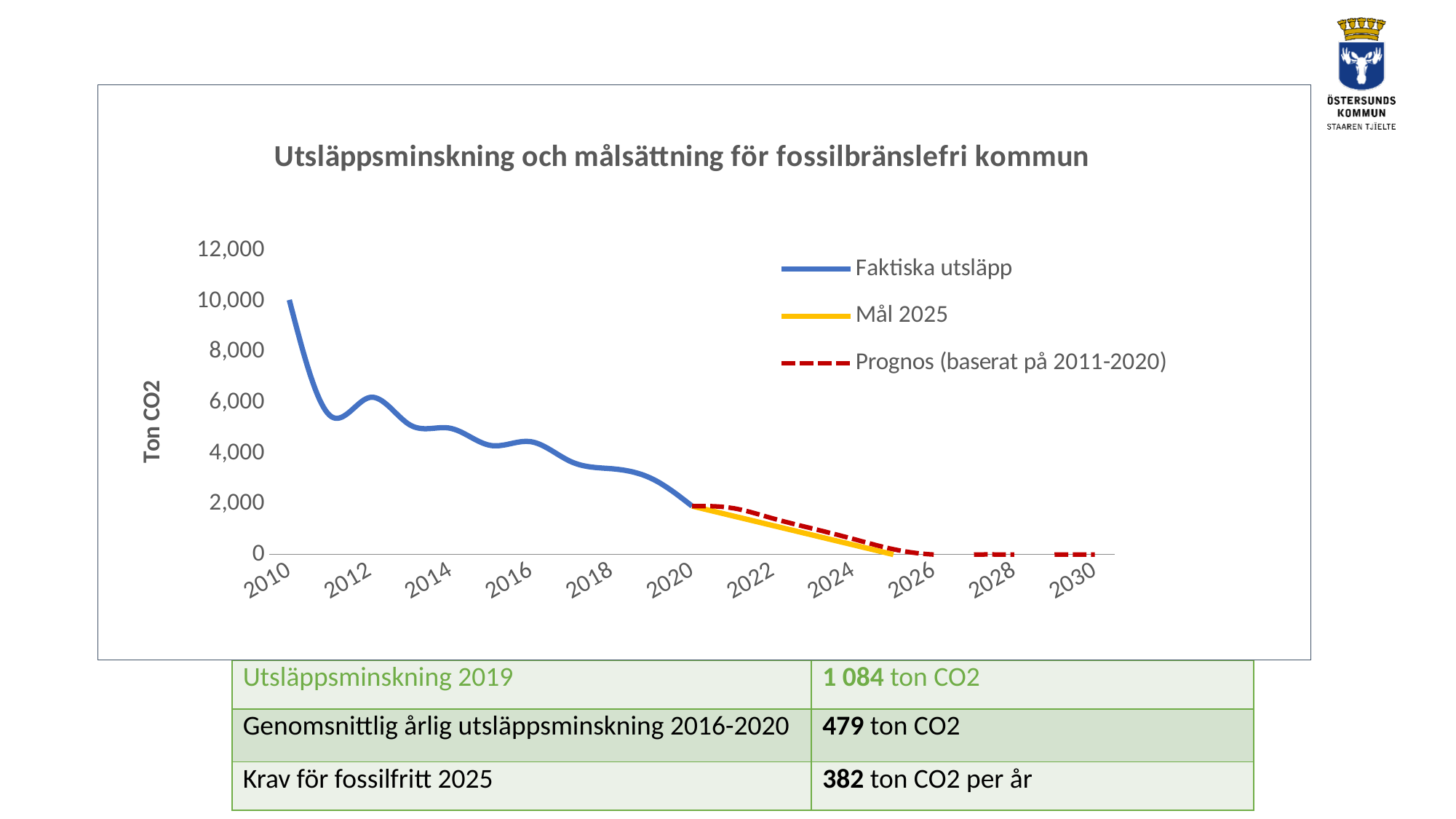
How many series does the chart legend list? 3 Is the value for Faktiska utsläpp in 2016 greater or less than 6,000? less Which series is drawn as a dashed line in the chart? Prognos (baserat på 2011-2020) Do the values of the Faktiska utsläpp series rise or fall overall from 2010 to 2020? fall Which is larger, the Faktiska utsläpp value in 2012 or in 2018? 2012 What is the title of the chart? Utsläppsminskning och målsättning för fossilbränslefri kommun What is the label on the vertical axis of the chart? Ton CO2 Is the value for Mål 2025 in 2024 greater or less than 2,000? less Is the value for Faktiska utsläpp in 2020 greater or less than 4,000? less In which year is the Faktiska utsläpp series at its highest? 2010 What kind of chart is shown on the slide? line chart